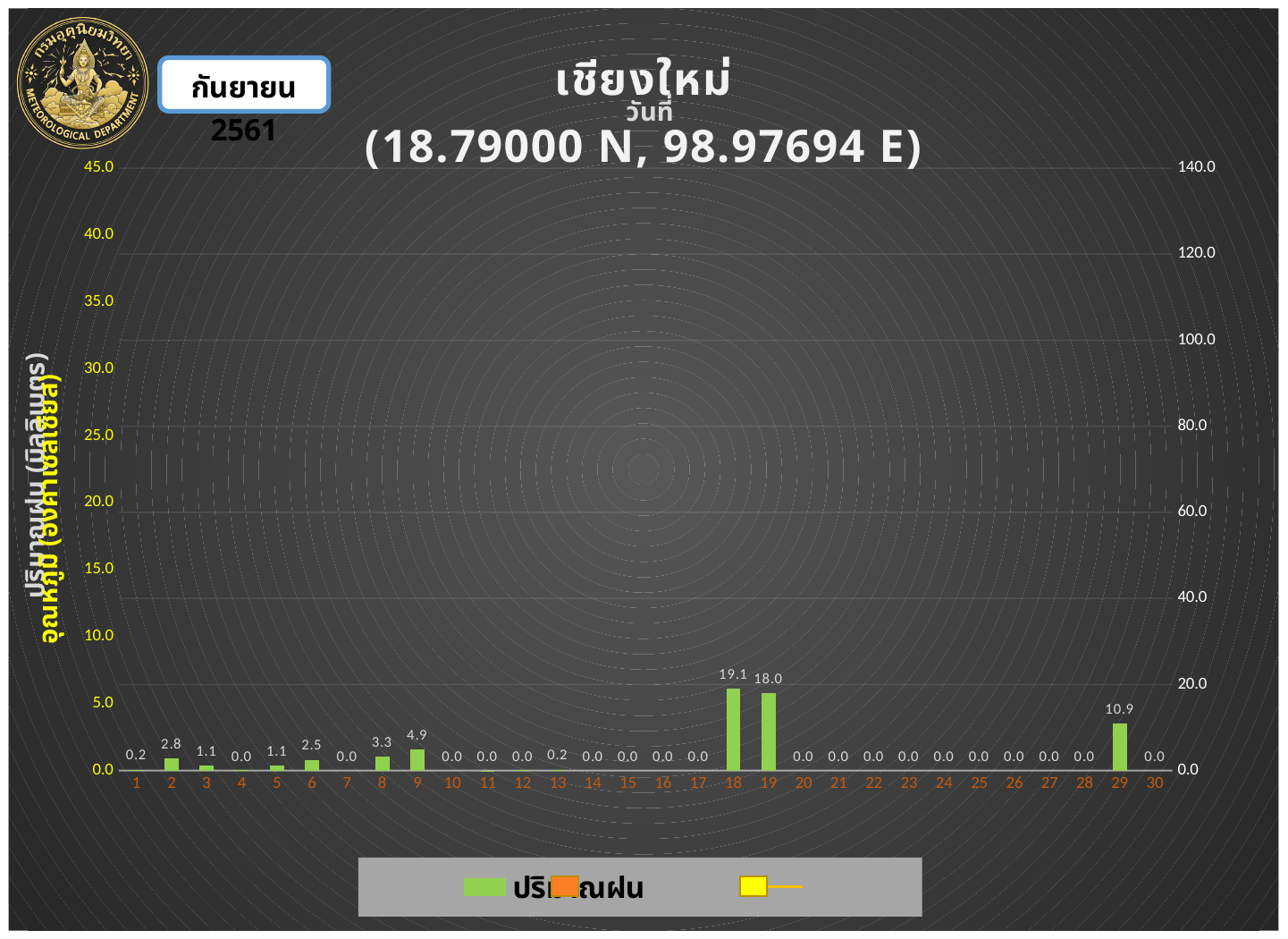
Which day has the highest rainfall value? 18 What kind of chart is used to show the rainfall values? bar chart What is the difference between the rainfall values for day 19 and day 29? 7.1 What is the rainfall value shown for day 18? 19.1 How many days are shown on the x axis? 30 Which has a larger rainfall value, day 6 or day 2? day 2 What are the coordinates shown in the chart title? 18.79000 N, 98.97694 E Which has a larger rainfall value, day 8 or day 9? day 9 What is the rainfall value shown for day 29? 10.9 What is the difference between the rainfall values for day 18 and day 19? 1.1 What is the rainfall value shown for day 2? 2.8 What is the rainfall value shown for day 9? 4.9